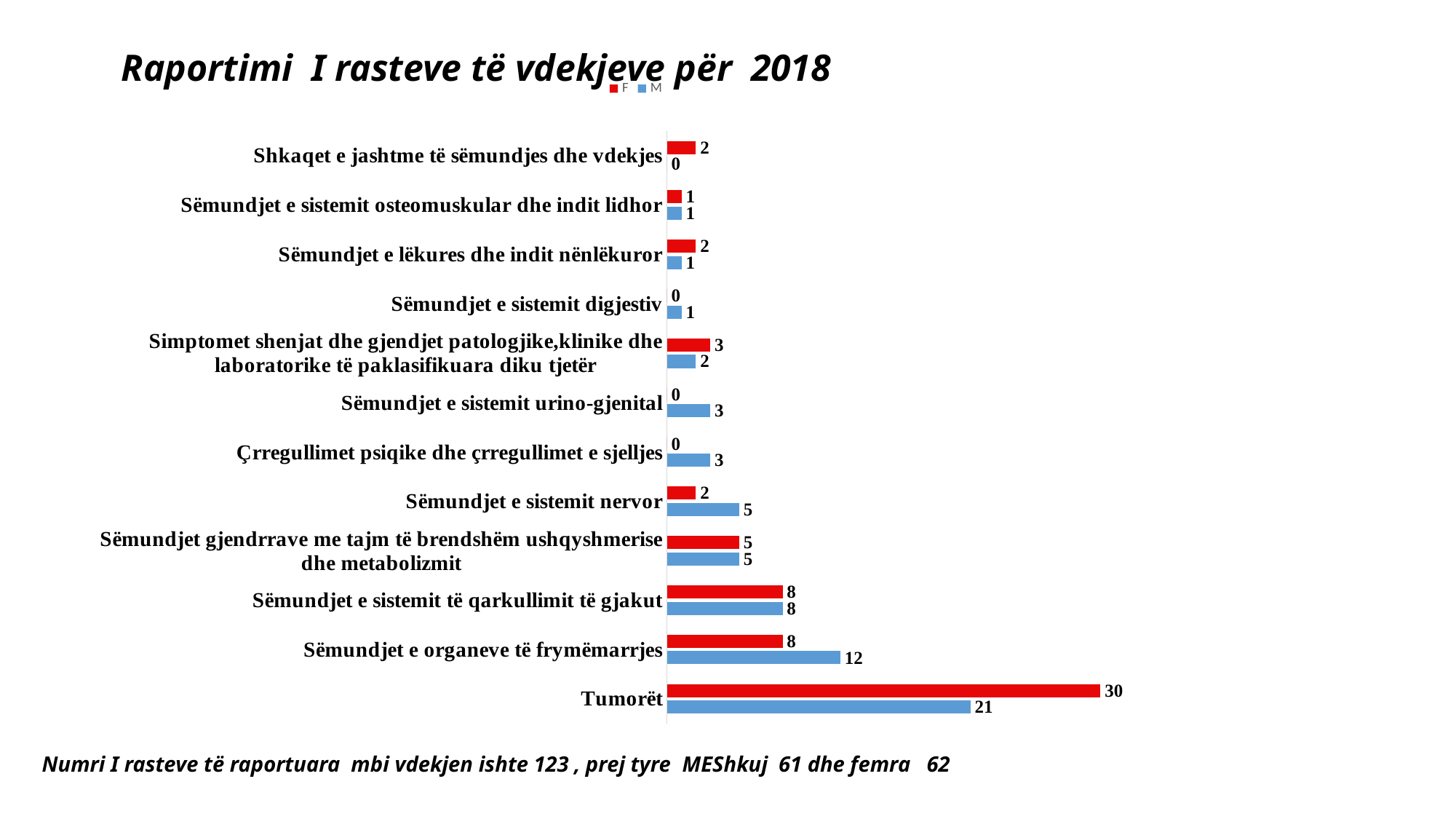
What is the M value for Sëmundjet e organeve të frymëmarrjes? 12 What is the F value for Tumorët? 30 What is the F value for Sëmundjet e sistemit urino-gjenital? 0 What is the difference between the M and F values for Sëmundjet e organeve të frymëmarrjes? 4 For Sëmundjet e sistemit nervor, which is larger, the F value or the M value? M How many categories are shown on the chart? 12 What kind of chart is shown on the slide? Bar chart What is the M value for Sëmundjet e sistemit nervor? 5 What is the difference between the F and M values for Tumorët? 9 How many series does the legend list? 2 Which colour represents the F series in the chart? Red Which category has the highest M value? Tumorët